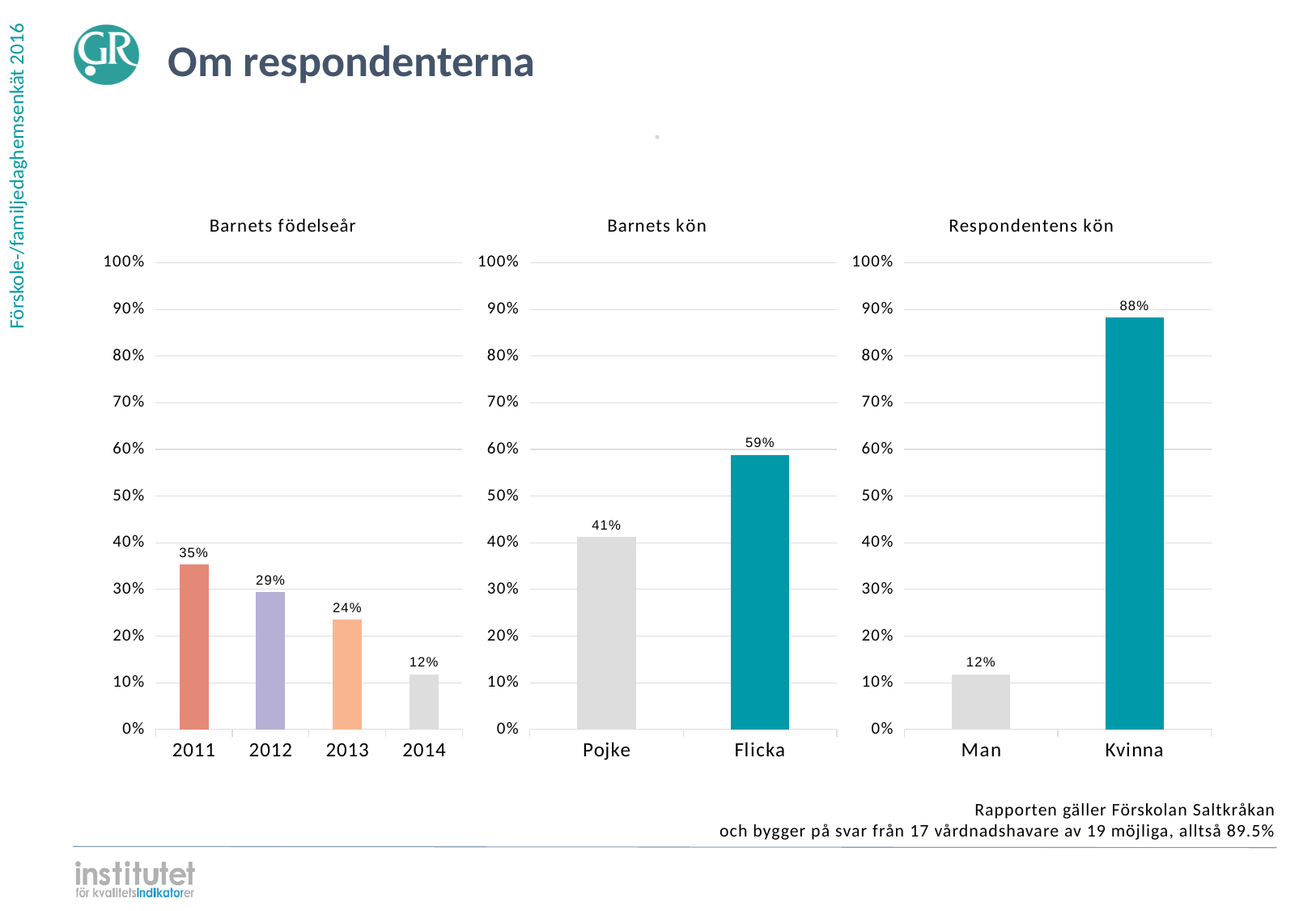
What kind of chart is the 'Respondentens kön' chart? bar chart How many categories are shown in the 'Barnets födelseår' chart? 4 In the 'Barnets födelseår' chart, which birth year has the lowest value? 2014 In the 'Barnets födelseår' chart, what is the value for 2011? 35% In the 'Barnets kön' chart, what is the difference between Flicka and Pojke? 18% In the 'Barnets kön' chart, which category is higher, Pojke or Flicka? Flicka In the 'Barnets födelseår' chart, what is the difference between the values for 2012 and 2013? 5% In the 'Respondentens kön' chart, what is the difference between Kvinna and Man? 76% In the 'Respondentens kön' chart, what is the value for Kvinna? 88% How many charts are shown on the slide? 3 In the 'Barnets födelseår' chart, do the values rise or fall from 2011 to 2014? fall In the 'Barnets kön' chart, what is the value for Pojke? 41%